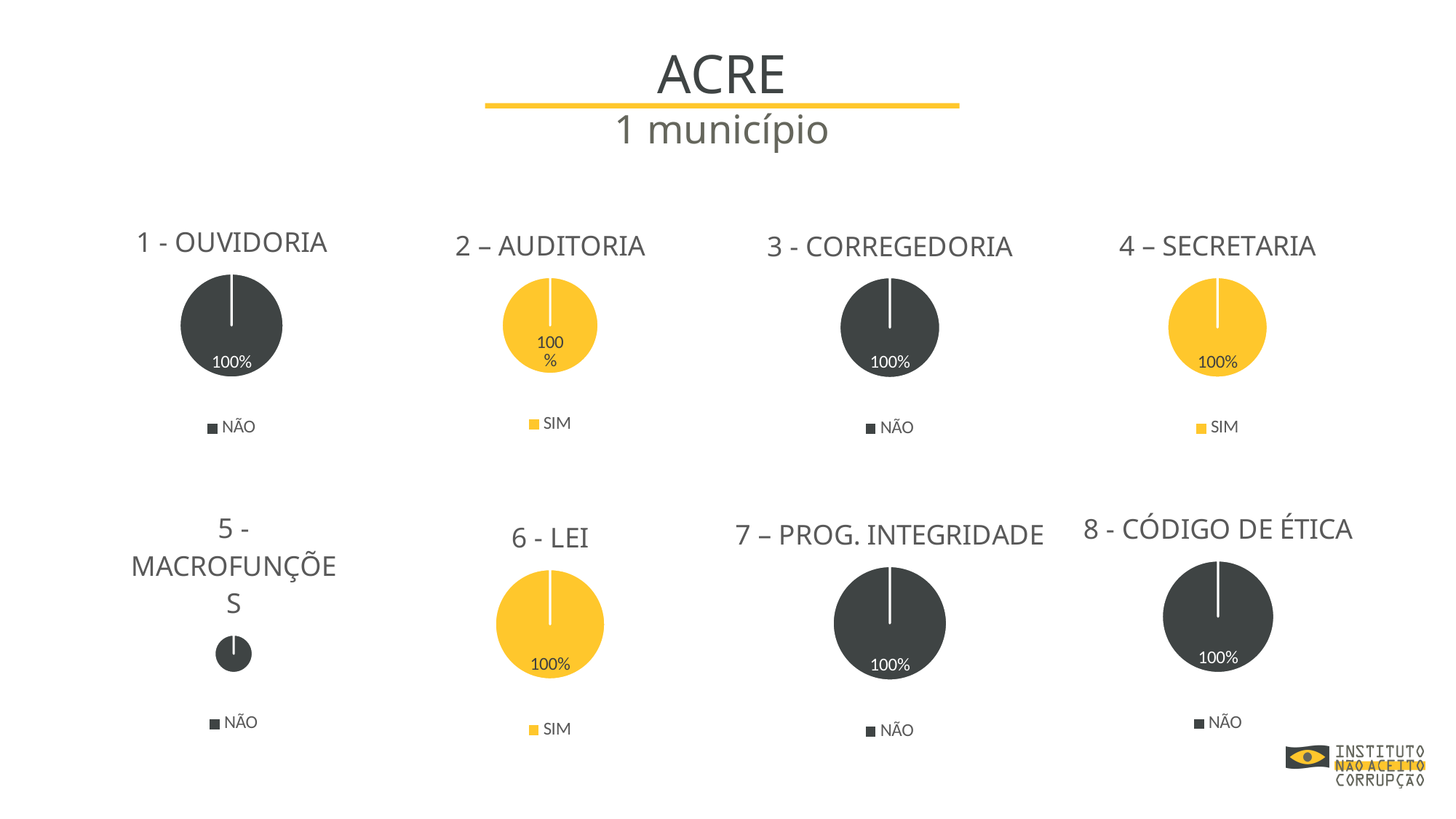
In the "7 – PROG. INTEGRIDADE" chart, what value is shown for NÃO? 100% Which legend entry is shown for the "6 - LEI" chart? SIM In the "3 - CORREGEDORIA" chart, what share does the NÃO slice have? 100% In the "1 - OUVIDORIA" chart, what share does the NÃO slice have? 100% In the "8 - CÓDIGO DE ÉTICA" chart, what share does the NÃO slice have? 100% What colour is the slice in the "2 – AUDITORIA" chart? yellow How many series does the legend of the "5 - MACROFUNÇÕES" chart list? 1 In the "2 – AUDITORIA" chart, what value is shown for SIM? 100% What kind of chart is used for "1 - OUVIDORIA"? pie chart How many pie charts are shown on the slide? 8 In the "4 – SECRETARIA" chart, what value is shown for SIM? 100%